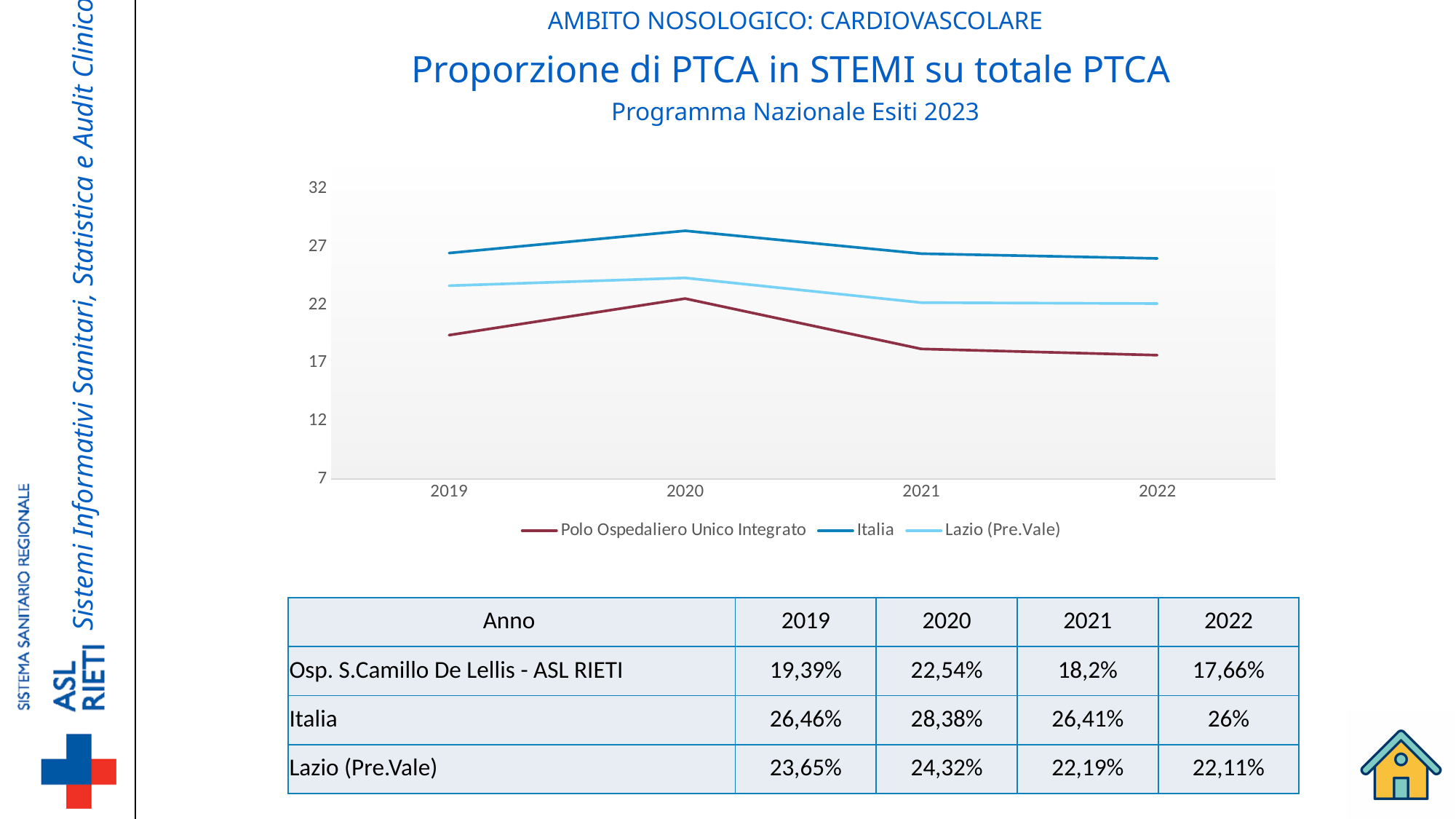
Does the Lazio (Pre.Vale) series rise or fall from 2020 to 2021? fall How many series does the chart legend list? 3 According to the table, what is the value for Lazio (Pre.Vale) in 2022? 22,11% According to the table, what is the value for Italia in 2020? 28,38% Is the value for Italia in 2020 greater or less than 27? greater Which series has the lowest values across all years in the chart? Polo Ospedaliero Unico Integrato Which series has the highest values across all years in the chart? Italia What is the title of the chart on the slide? Proporzione di PTCA in STEMI su totale PTCA What kind of chart is shown on the slide? line chart Is the value for Polo Ospedaliero Unico Integrato in 2022 greater or less than 22? less In which year does the Italia series reach its peak? 2020 How many years are plotted along the x axis of the chart? 4